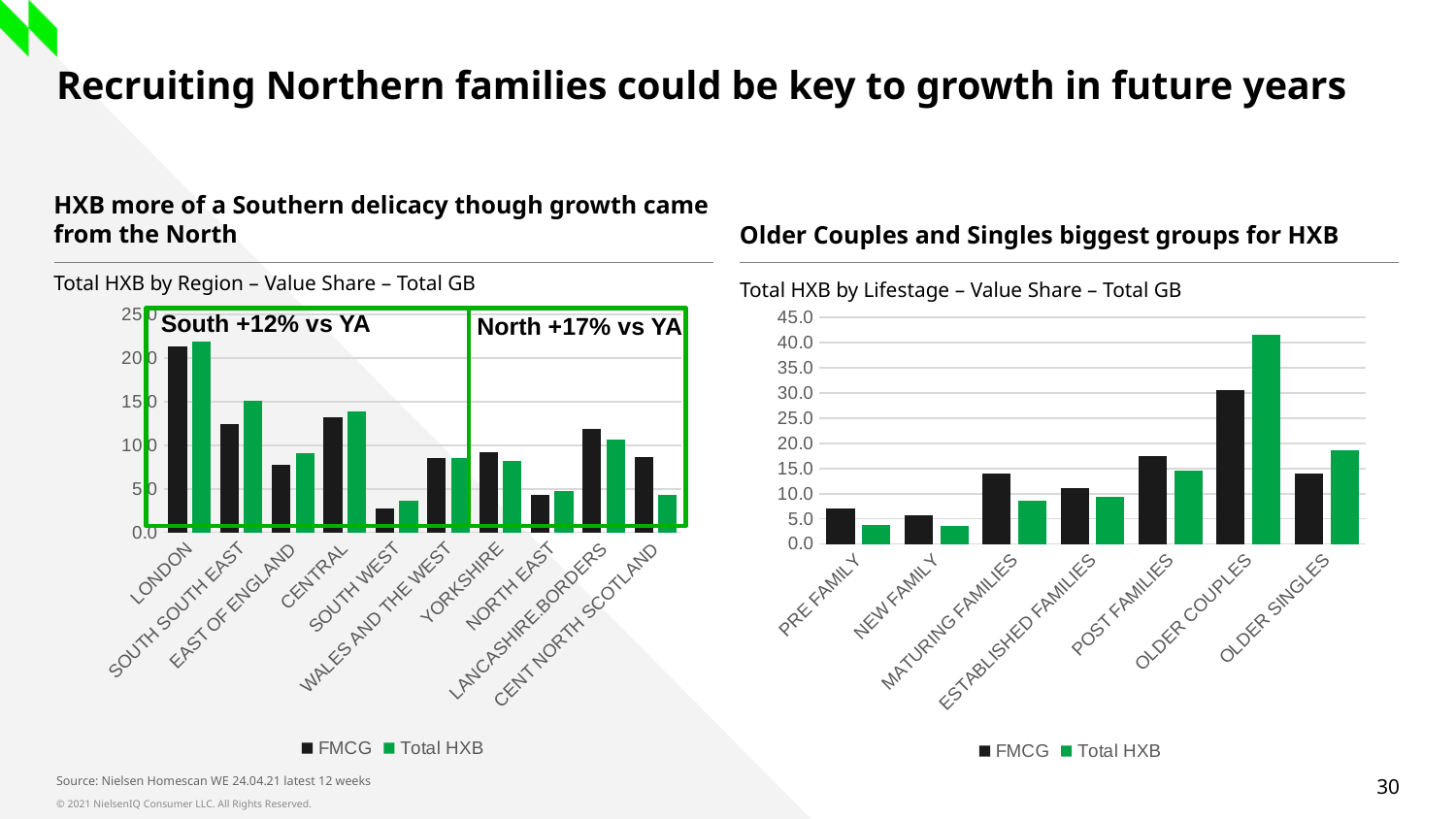
On the 'Total HXB by Region' chart, which region has the highest Total HXB value? LONDON On the 'Total HXB by Lifestage' chart, which lifestage has the highest Total HXB value? OLDER COUPLES On the 'Total HXB by Region' chart, what growth vs YA is shown in the box labelled North? +17% vs YA On the 'Total HXB by Region' chart, is the Total HXB value for LONDON greater or less than 20? greater What kind of chart is the 'Total HXB by Region – Value Share – Total GB' chart on the left? bar chart How many lifestage categories are shown on the 'Total HXB by Lifestage – Value Share – Total GB' chart? 7 How many series does the legend list for the 'Total HXB by Lifestage – Value Share – Total GB' chart on the right? 2 On the 'Total HXB by Lifestage' chart, for PRE FAMILY, which series has the larger value, FMCG or Total HXB? FMCG How many regions are shown on the 'Total HXB by Region – Value Share – Total GB' chart? 10 On the 'Total HXB by Region' chart, which region has the lowest Total HXB value? SOUTH WEST On the 'Total HXB by Lifestage' chart, is the Total HXB value for OLDER COUPLES greater or less than 40? greater On the 'Total HXB by Lifestage' chart, is the Total HXB value for OLDER SINGLES greater or less than 15? greater